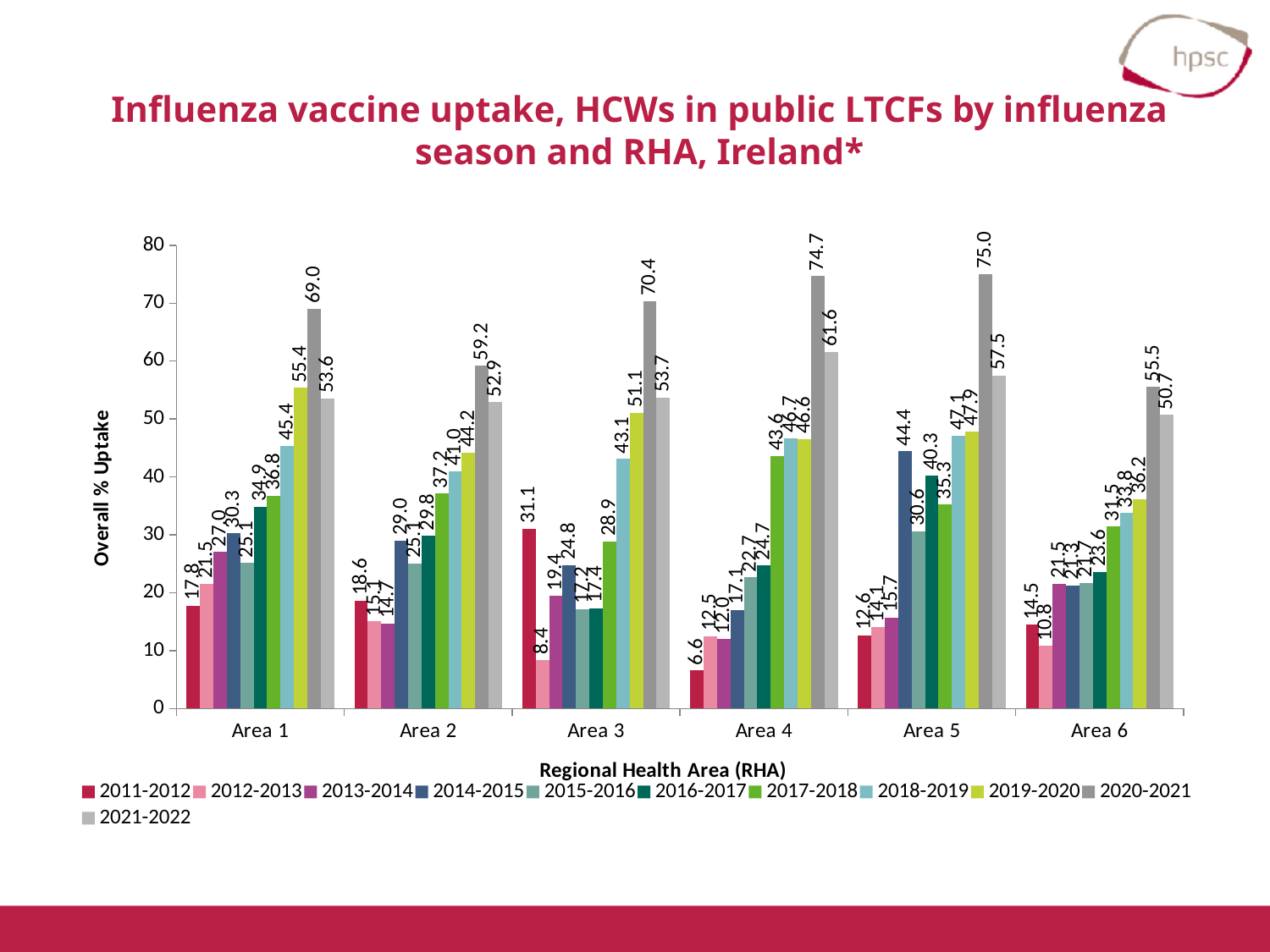
Which area had the lowest overall % uptake in the 2011-2012 season? Area 4 What was the overall % uptake for Area 5 in the 2020-2021 season? 75.0 What kind of chart is shown on the slide? Bar chart What was the overall % uptake for Area 3 in the 2012-2013 season? 8.4 Is the 2014-2015 uptake value for Area 5 greater or less than 40? greater Which area had the highest overall % uptake in the 2021-2022 season? Area 4 What was the overall % uptake for Area 6 in the 2021-2022 season? 50.7 Which had the higher 2020-2021 uptake, Area 1 or Area 2? Area 1 What is the title of the y axis? Overall % Uptake How many influenza seasons does the legend list? 11 What is the difference between the 2020-2021 and 2021-2022 uptake values for Area 4? 13.1 How many Regional Health Areas are shown on the x axis? 6